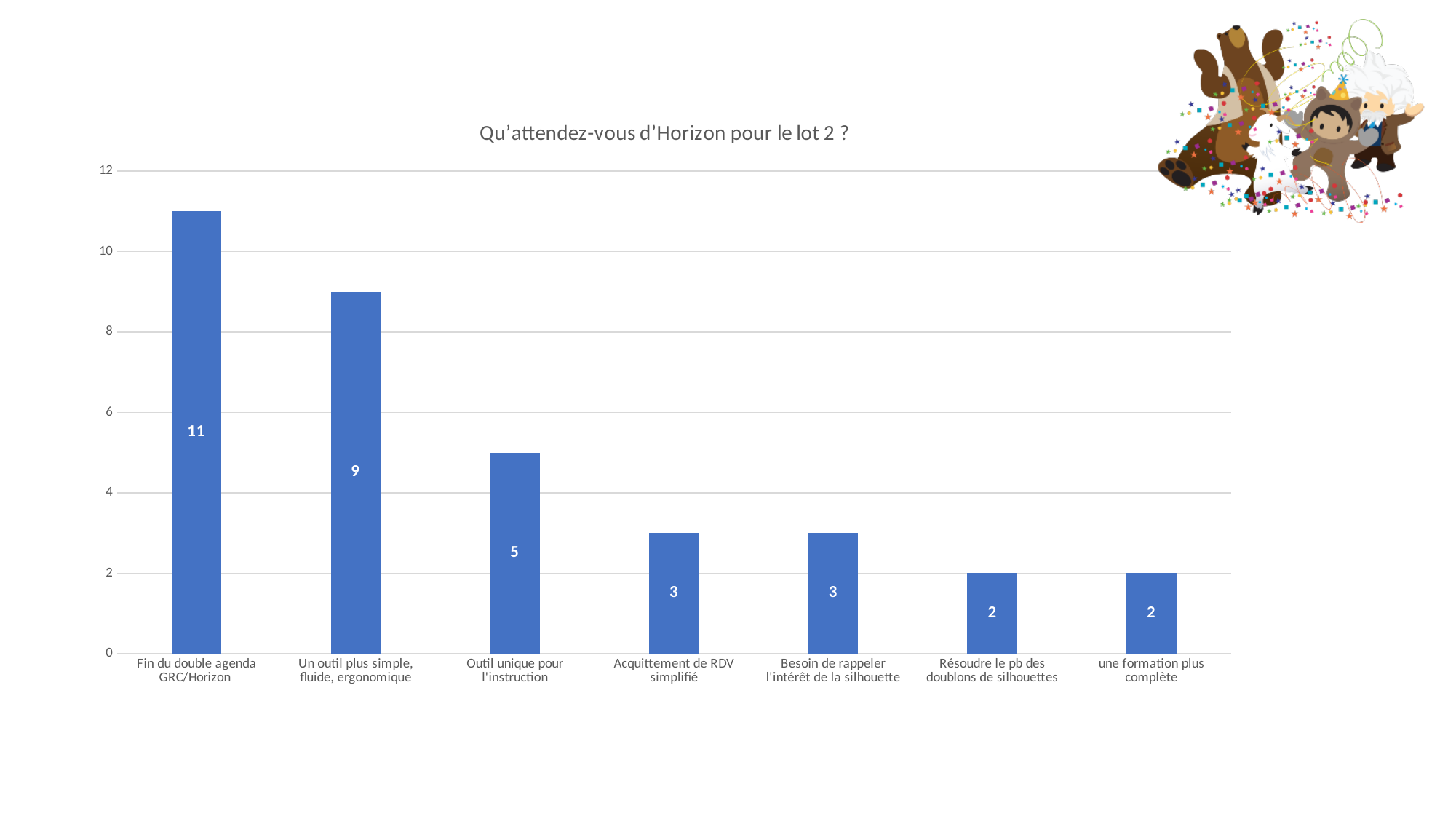
Which is larger: "Outil unique pour l'instruction" or "Besoin de rappeler l'intérêt de la silhouette"? Outil unique pour l'instruction What is the value for "une formation plus complète"? 2 What is the value for "Outil unique pour l'instruction"? 5 What is the difference between "Un outil plus simple, fluide, ergonomique" and "Outil unique pour l'instruction"? 4 What is the difference between "Fin du double agenda GRC/Horizon" and "Un outil plus simple, fluide, ergonomique"? 2 How many categories are shown on the chart? 7 Is the value for "Un outil plus simple, fluide, ergonomique" greater or less than 8? greater What kind of chart is shown on the slide? bar chart What is the title of the chart? Qu’attendez-vous d’Horizon pour le lot 2 ? What is the value for "Acquittement de RDV simplifié"? 3 Which category has the highest value? Fin du double agenda GRC/Horizon What is the value for "Fin du double agenda GRC/Horizon"? 11